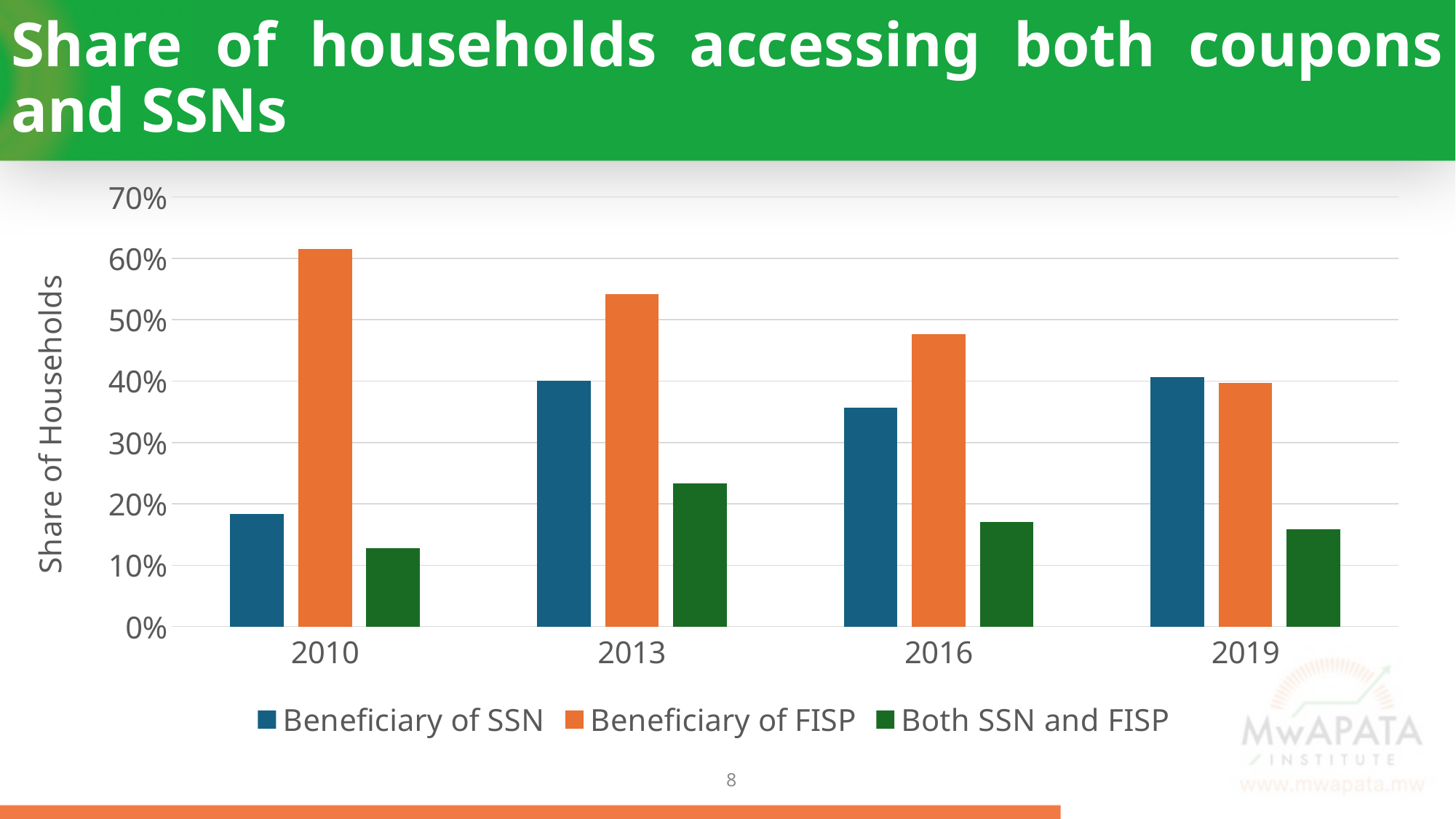
Is the Beneficiary of FISP value for 2010 greater or less than 60%? greater How many years are shown on the x axis? 4 In which year is the Beneficiary of SSN share lowest? 2010 Is the Both SSN and FISP value for 2013 greater or less than 20%? greater In which year is the Beneficiary of FISP share highest? 2010 What kind of chart is shown on the slide? Bar chart Does the Beneficiary of FISP share rise or fall from 2010 to 2019? Fall In which year is the Both SSN and FISP share lowest? 2010 Is the Beneficiary of SSN value for 2010 greater or less than 20%? less What is the title of the y axis? Share of Households How many series does the legend list? 3 In 2013, which is larger: Beneficiary of SSN or Beneficiary of FISP? Beneficiary of FISP